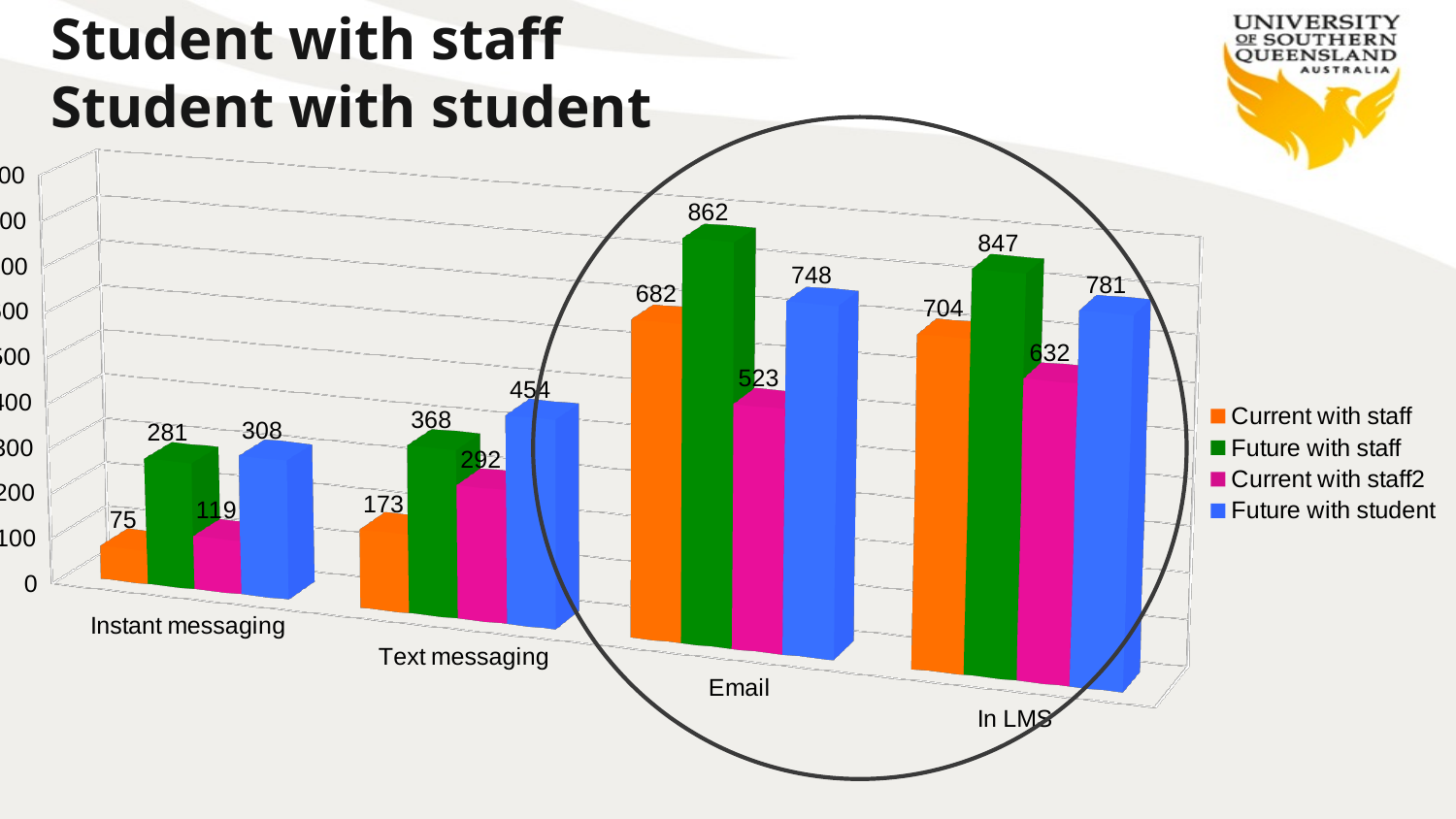
How many categories are shown on the x axis? 4 What is the difference between Future with staff and Current with staff in the In LMS category? 143 What is the value for Future with student in the Text messaging category? 454 How many series does the legend list? 4 What kind of chart is shown on the slide? Bar chart Which category has the highest value for Future with staff? Email What is the value for Future with staff in the Email category? 862 Which colour represents the Future with student series? Blue What is the value for Current with staff in the Instant messaging category? 75 Which is larger in the Email category: Current with staff or Future with student? Future with student What is the value for Current with staff2 in the In LMS category? 632 Which category has the lowest value for Current with staff? Instant messaging